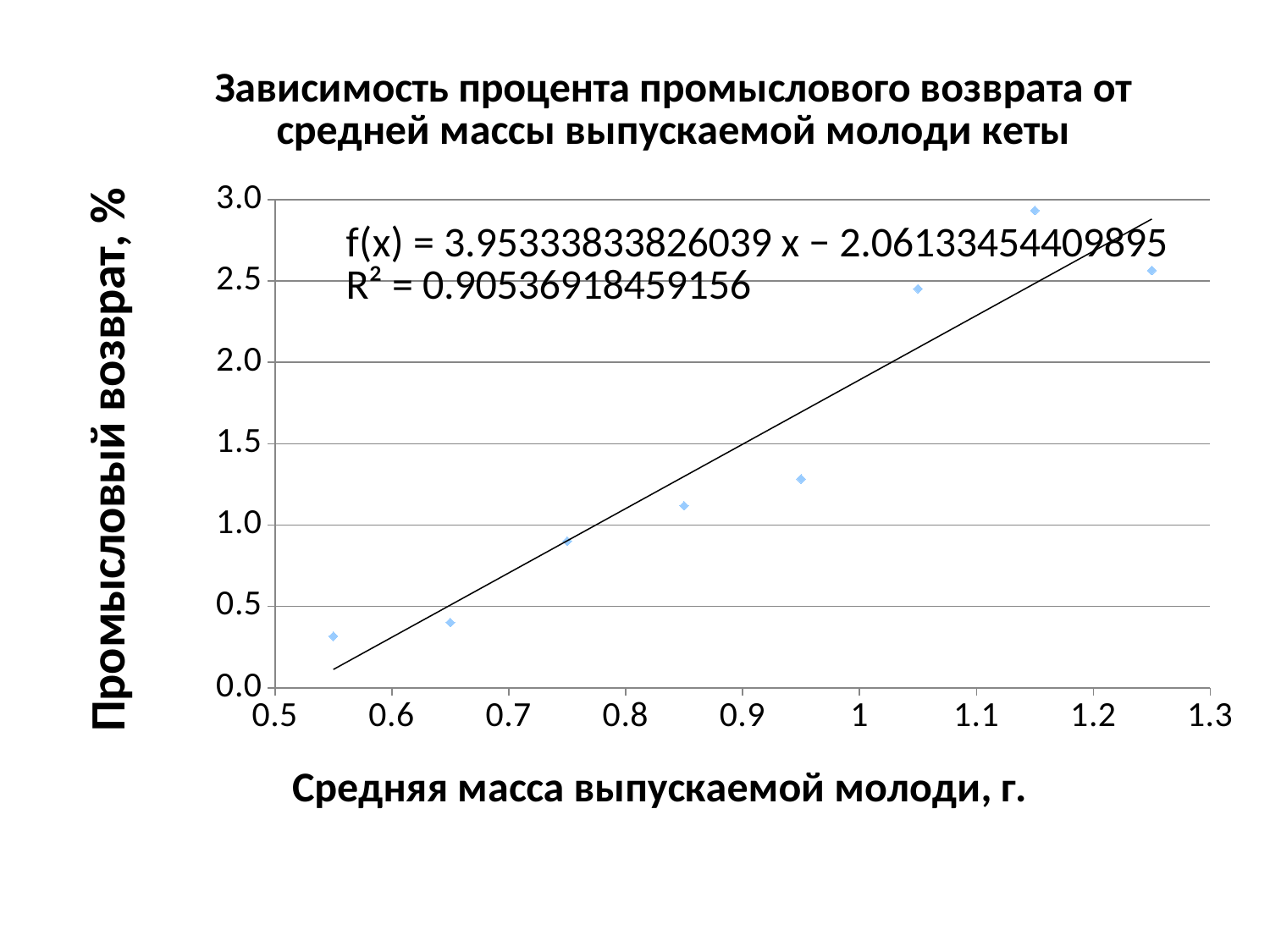
What kind of chart is shown on the slide? Scatter chart Which point has a higher commercial return value: the one at x = 1.15 or the one at x = 1.25? x = 1.15 Do the plotted values rise or fall as the average mass of released juveniles increases along the x axis? Rise What is the label of the x axis? Средняя масса выпускаемой молоди, г. Is the commercial return value for the point at x = 0.75 greater or less than 1.0? less What R² value is printed on the chart for the trendline? R² = 0.90536918459156 Is the commercial return value for the point at x = 0.95 greater or less than 1.0? greater Is the commercial return value for the point at x = 0.65 greater or less than 0.5? less How many data points are plotted on the chart? 8